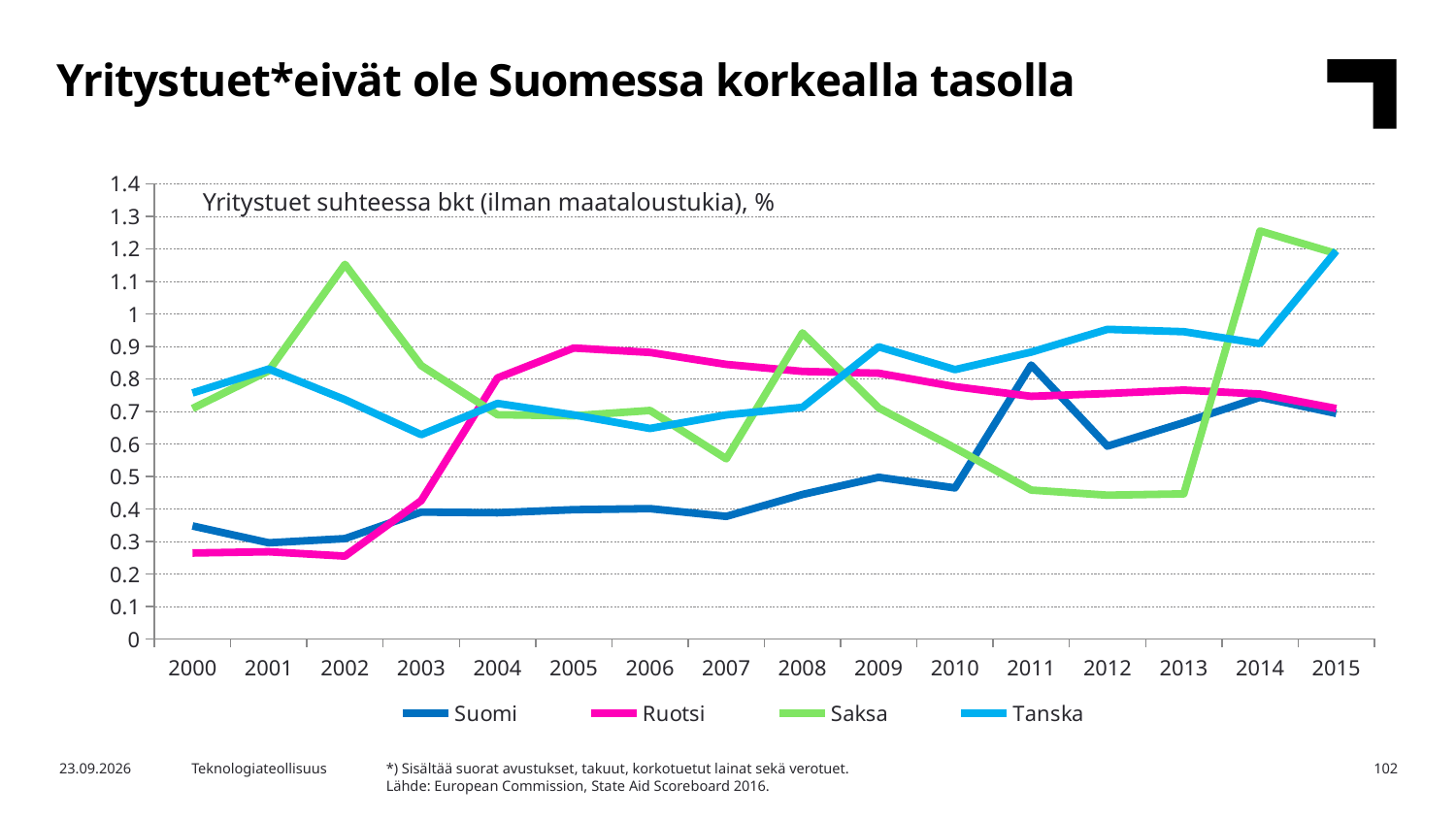
Is the value for Saksa in 2002 greater or less than 1? greater What kind of chart is shown on the slide? Line chart Which series has the highest value in 2014? Saksa What is the title printed inside the chart area? Yritystuet suhteessa bkt (ilman maataloustukia), % Is the value for Ruotsi in 2002 greater or less than 0.3? less How many years are plotted along the x axis? 16 Which series has the lowest value in 2000? Ruotsi How many series does the legend list? 4 Which series has the lowest value in 2013? Saksa Does the Suomi line overall rise or fall from 2000 to 2015? Rise Is the value for Tanska in 2015 greater or less than 1? greater In 2010, which is larger, the value for Ruotsi or the value for Saksa? Ruotsi